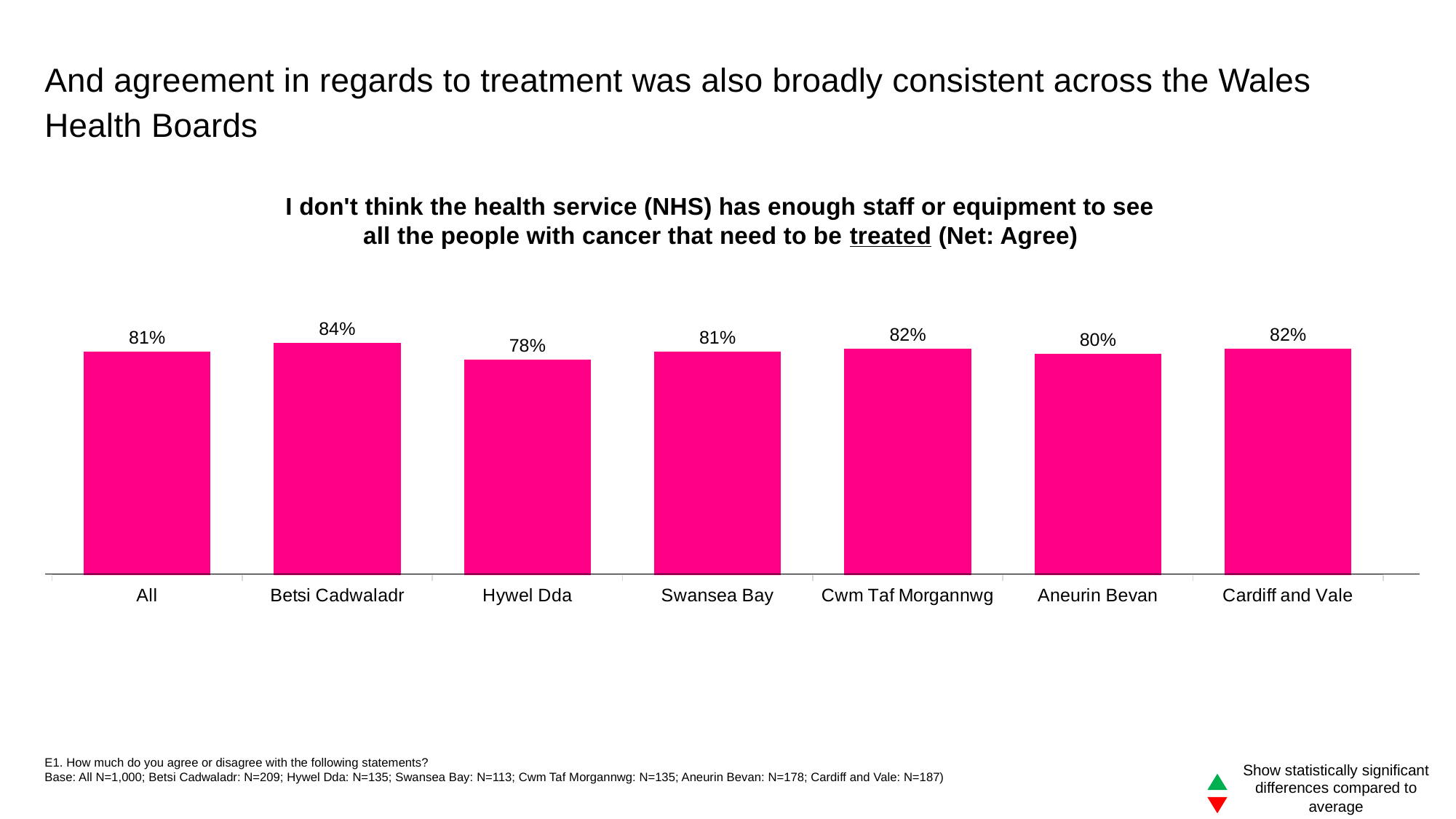
What is the value for Hywel Dda? 78% What is the difference between the values for Betsi Cadwaladr and Hywel Dda? 6% What is the value for Betsi Cadwaladr? 84% What kind of chart is shown on the slide? Bar chart What is the difference between the values for Cwm Taf Morgannwg and Aneurin Bevan? 2% How many categories are shown on the chart? 7 What is the value for Aneurin Bevan? 80% What colour are the bars in the chart? Pink Which category has the lowest value? Hywel Dda Which is larger, the value for Cardiff and Vale or the value for Hywel Dda? Cardiff and Vale Which category has the highest value? Betsi Cadwaladr What is the value for the All category? 81%